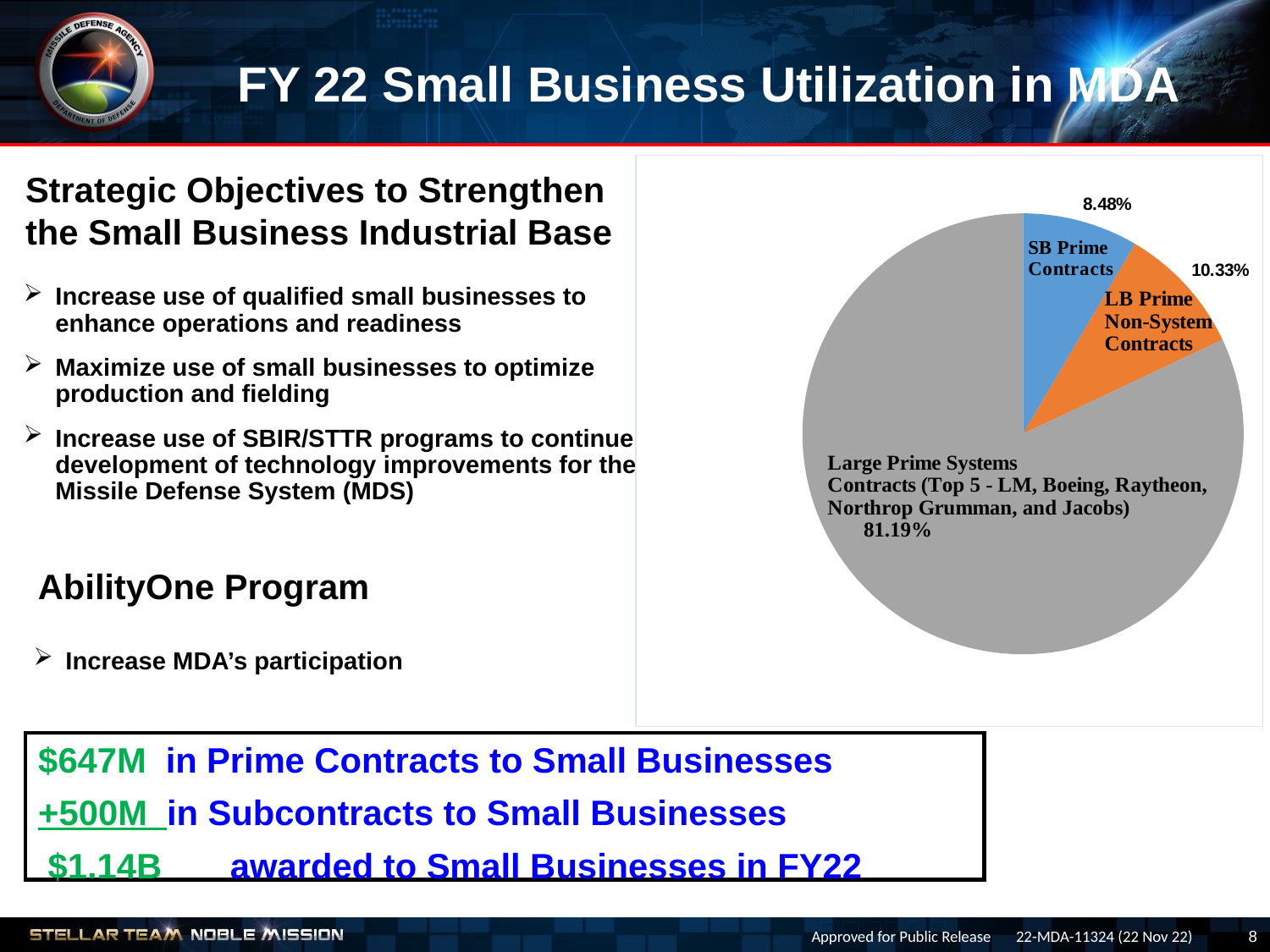
How many slices does the pie chart have? 3 Which slice of the pie is the largest? Large Prime Systems Contracts What is the difference in percentage points between the LB Prime Non-System Contracts slice and the SB Prime Contracts slice? 1.85 Which is larger, the SB Prime Contracts slice or the LB Prime Non-System Contracts slice? LB Prime Non-System Contracts What share of the pie is labelled Large Prime Systems Contracts? 81.19% What share of the pie is labelled LB Prime Non-System Contracts? 10.33% What share of the pie is labelled SB Prime Contracts? 8.48% What colour is the Large Prime Systems Contracts slice? grey Which slice of the pie is the smallest? SB Prime Contracts What colour is the SB Prime Contracts slice? blue What is the combined share of the SB Prime Contracts and LB Prime Non-System Contracts slices? 18.81% What kind of chart is shown on the slide? pie chart